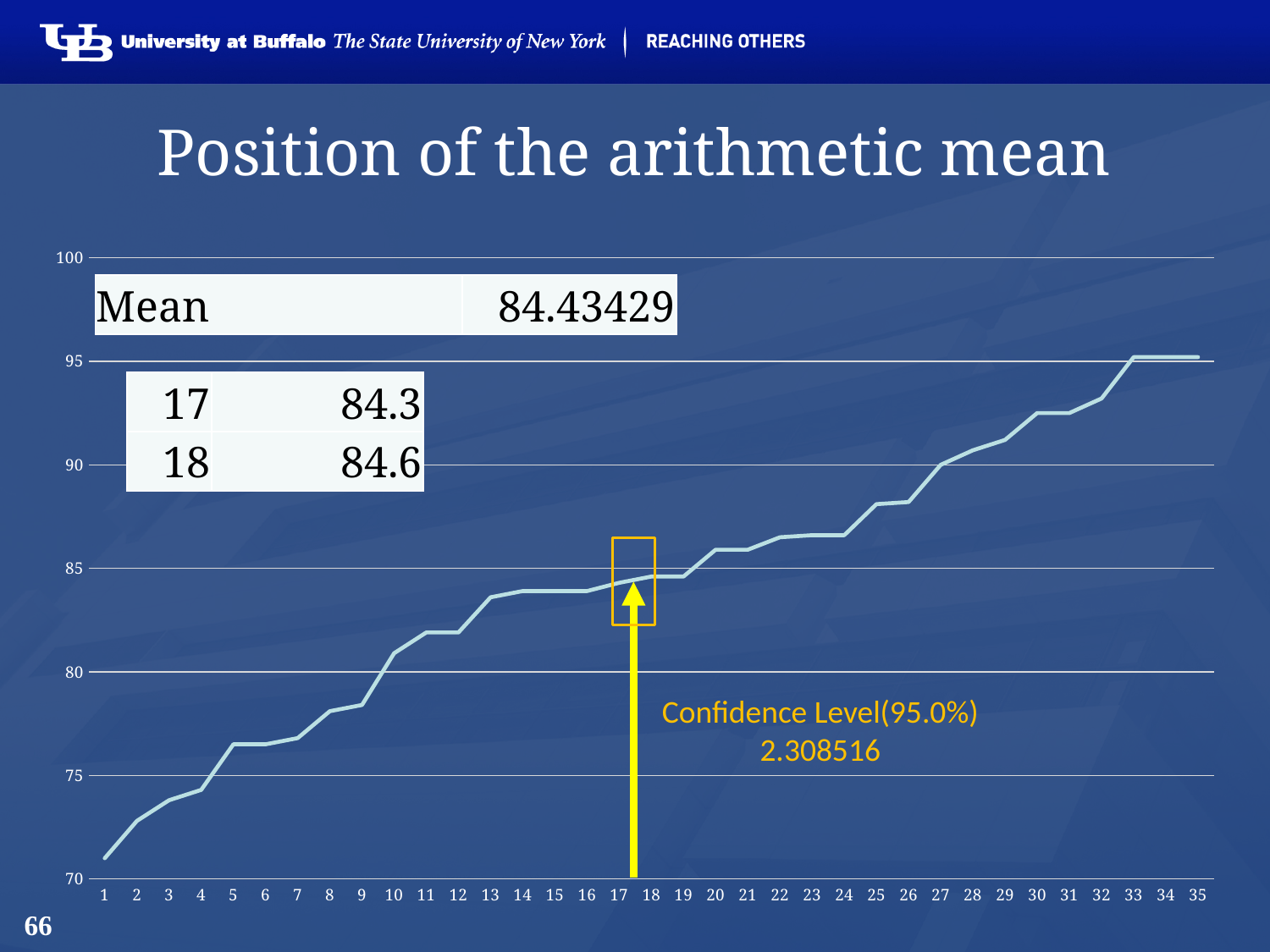
Is the value at position 27 greater or less than 85? greater Which has the larger value, position 17 or position 18? 18 Which position has the lowest value? 1 What is the value at position 18? 84.6 How many points are plotted along the x axis? 35 What kind of chart is shown on the slide? line chart Is the value at position 5 greater or less than 80? less Do the values rise or fall as the x axis goes from 1 to 35? rise Is the value at position 1 greater or less than 75? less What is the value at position 17? 84.3 What mean value is shown on the slide? 84.43429 What is the difference between the values at positions 18 and 17? 0.3